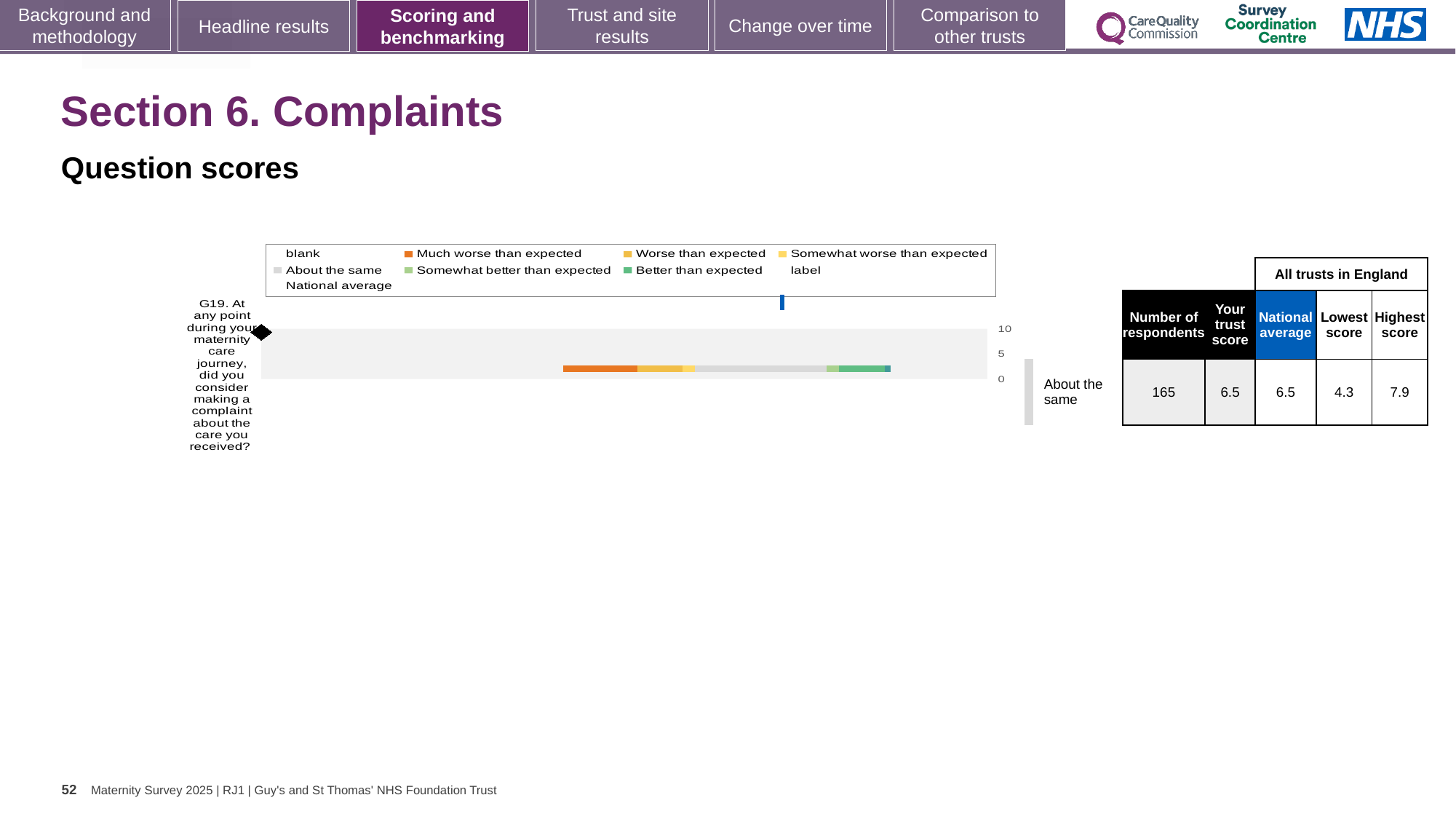
What kind of chart is shown on the slide? bar chart What colour does the legend use for 'Much worse than expected'? orange How many questions (categories) are plotted in the chart? 1 Which question is plotted in the chart? G19. At any point during your maternity care journey, did you consider making a complaint about the care you received? According to the table beside the chart, what is your trust score for G19? 6.5 According to the table beside the chart, what is the national average for G19? 6.5 According to the table beside the chart, what is the lowest score across all trusts in England for G19? 4.3 According to the table beside the chart, what is the highest score across all trusts in England for G19? 7.9 According to the table beside the chart, what is the number of respondents for G19? 165 How many entries does the chart legend list? 9 What is the difference between the highest score and the lowest score for G19 in the table beside the chart? 3.6 What benchmark category is given for G19 next to the chart? About the same